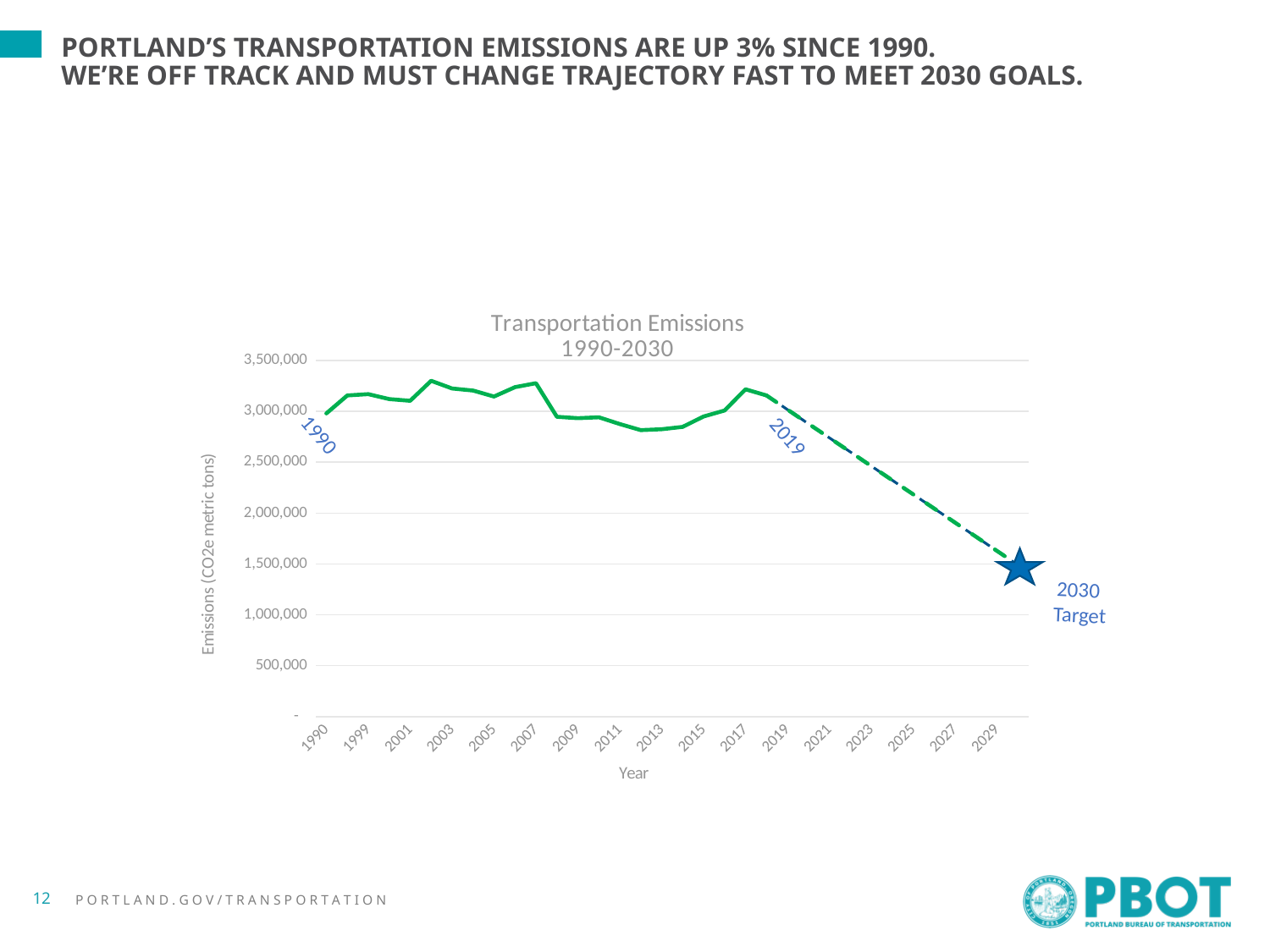
Is the emissions value for 2019 greater or less than 2,500,000? greater Is the emissions value for 1990 greater or less than 2,500,000? greater Is the emissions value for 2013 greater or less than 3,000,000? less Does the dashed line from 2019 to 2030 rise or fall? fall Which is larger, the emissions value for 1990 or the emissions value for 2007? 2007 What is the title of the chart? Transportation Emissions 1990-2030 What is the highest value shown on the vertical axis of the chart? 3,500,000 Which is larger, the emissions value for 2019 or the 2030 Target value? 2019 What is the label on the vertical axis of the chart? Emissions (CO2e metric tons) What kind of chart is shown on the slide? line chart